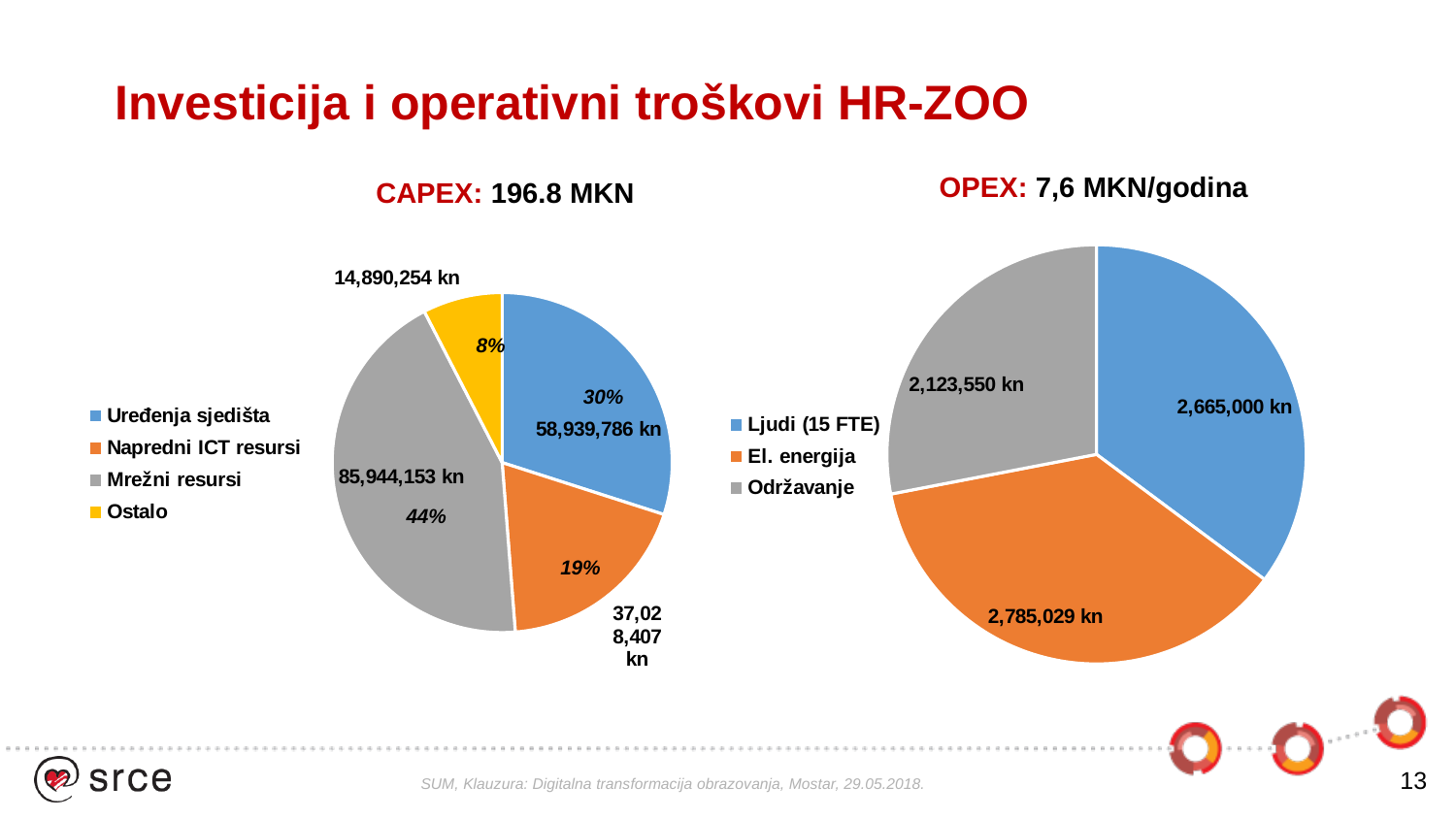
What kind of chart is the CAPEX chart on the left? pie chart How many categories does the CAPEX pie chart have? 4 In the CAPEX chart, what share of the pie does Uređenja sjedišta take? 30% In the OPEX chart, which category has the largest value? El. energija In the OPEX chart, which category has the smallest value? Održavanje In the CAPEX chart, what is the value for Mrežni resursi? 85,944,153 kn In the OPEX chart, what is the difference between El. energija and Ljudi (15 FTE)? 120,029 kn In the CAPEX chart, which category has the smallest slice? Ostalo In the CAPEX chart, which category has the largest slice? Mrežni resursi In the CAPEX chart, which is larger: Uređenja sjedišta or Napredni ICT resursi? Uređenja sjedišta What total CAPEX amount is stated above the left chart? 196.8 MKN In the OPEX chart, what is the value for El. energija? 2,785,029 kn